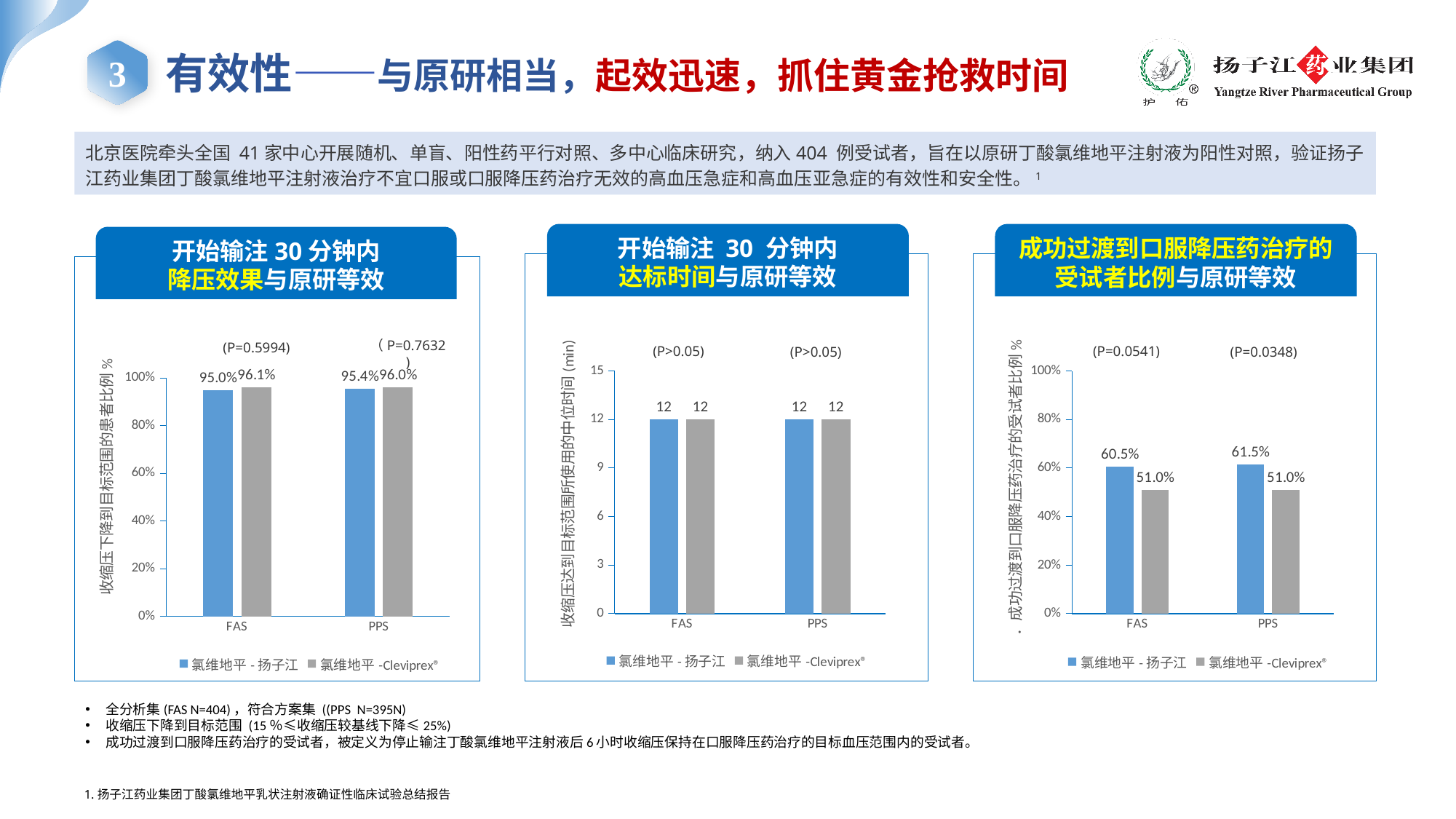
In the left chart, what is the difference between the 氯维地平-Cleviprex and 氯维地平-扬子江 values in the FAS group? 1.1% In the right chart, what is the value for 氯维地平-Cleviprex in the FAS group? 51.0% In the right chart, which series has the higher value in the FAS group? 氯维地平-扬子江 In the middle chart, what is the maximum value shown on the y axis? 15 In the middle chart, how many categories are shown on the x axis? 2 In the left chart, what is the value for 氯维地平-Cleviprex in the PPS group? 96.0% In the right chart, what is the value for 氯维地平-扬子江 in the PPS group? 61.5% In the left chart, what is the value for 氯维地平-扬子江 in the FAS group? 95.0% In the middle chart, what is the median time (min) for 氯维地平-扬子江 in the PPS group? 12 How many series does the legend of the right chart list? 2 In the right chart, what is the difference between the 氯维地平-扬子江 and 氯维地平-Cleviprex values in the PPS group? 10.5% What type of chart is the left chart? Bar chart